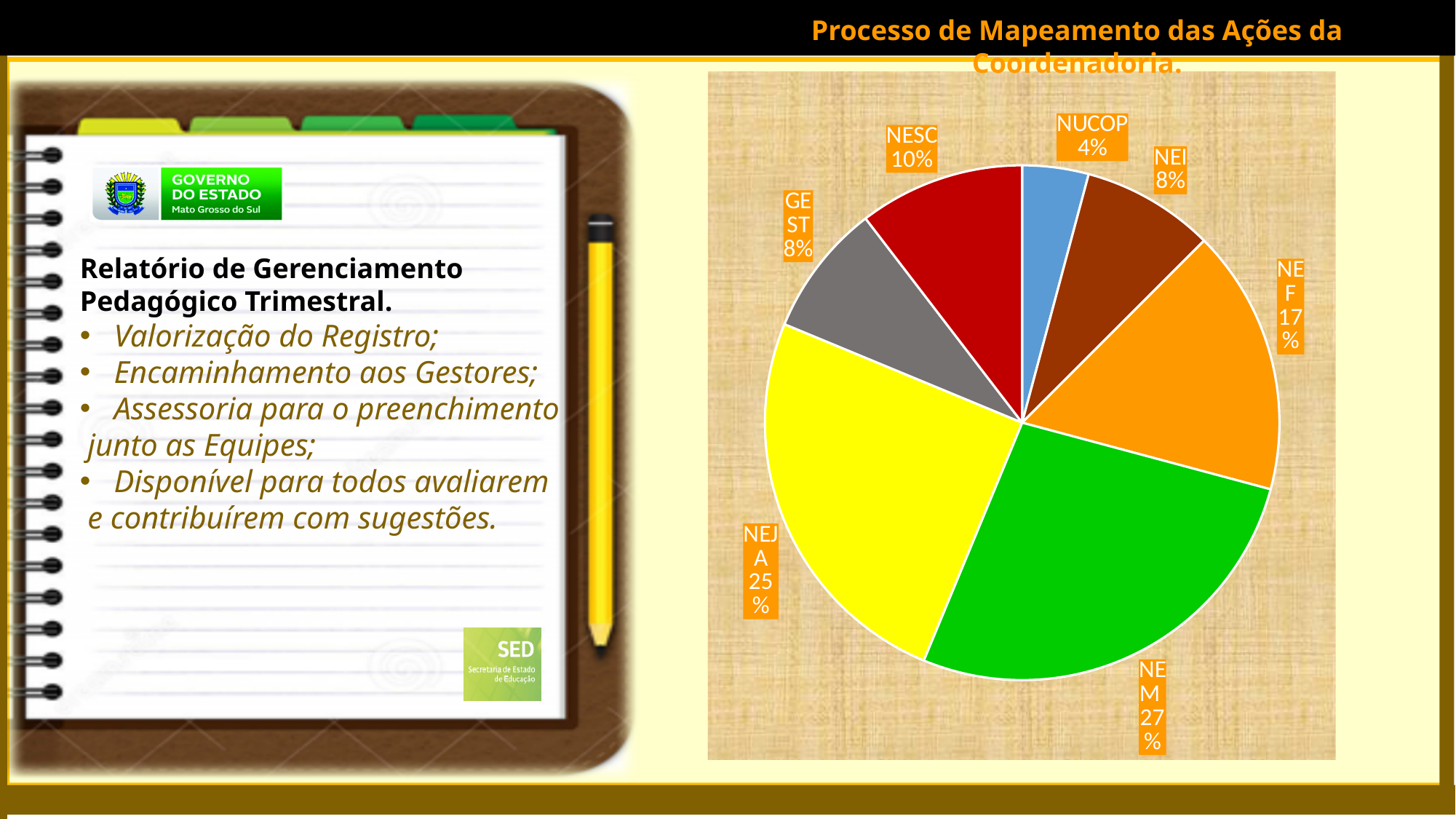
What share of the pie does NEM represent? 27% How many slices does the pie chart have? 7 What is the difference between the NEM and NEJA shares? 2% Which category has the largest slice of the pie? NEM What share of the pie does NEJA represent? 25% What is the value shown for NEF? 17% Which is larger, the share for NEF or the share for NESC? NEF What is the value shown for NESC? 10% Which category has the smallest slice of the pie? NUCOP What colour is the NEM slice of the pie? green What kind of chart is shown on the slide? pie chart What is the value shown for NUCOP? 4%